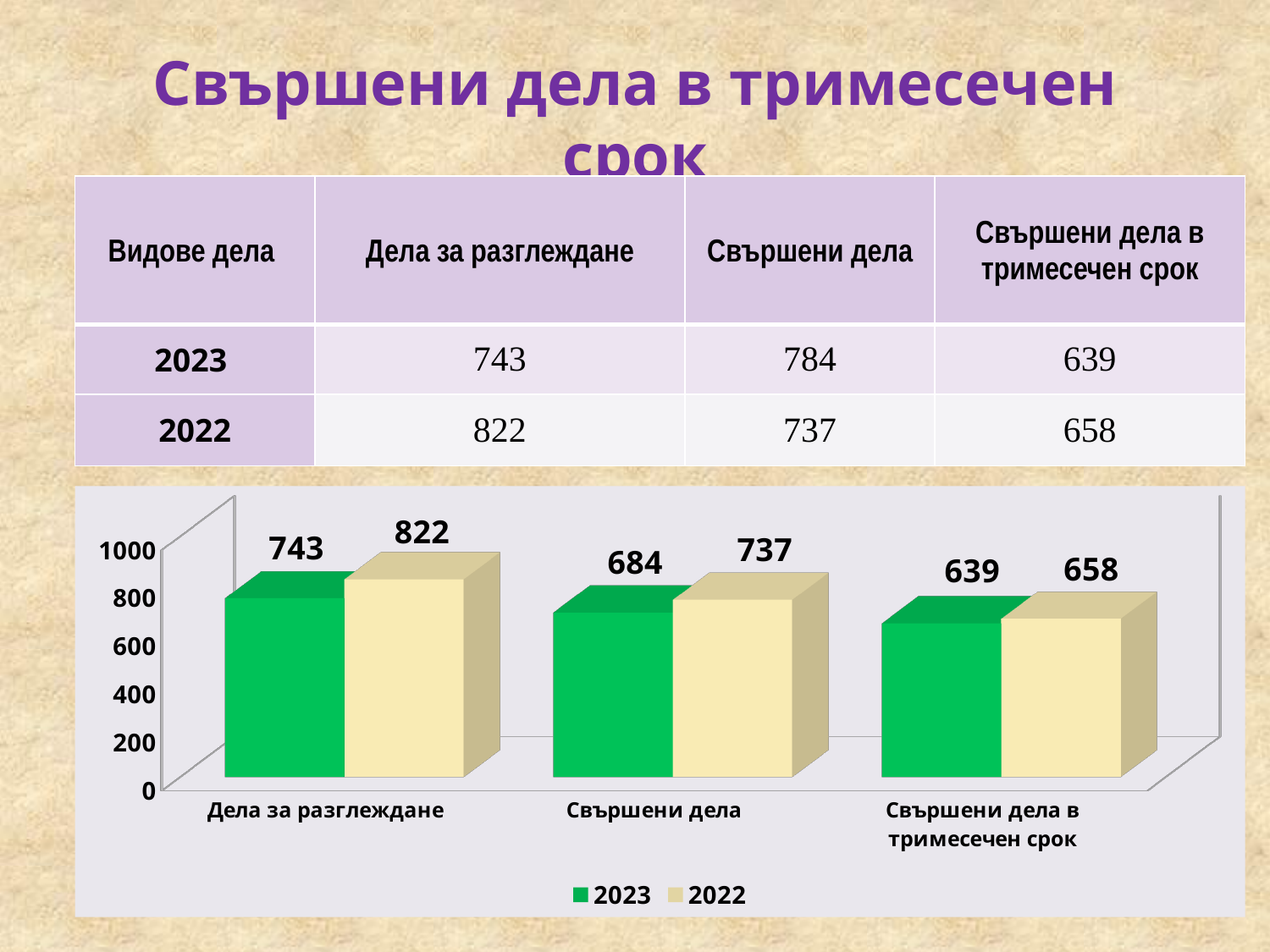
How many categories are shown on the x axis of the chart? 3 Which category has the lowest value for the 2023 series? Свършени дела в тримесечен срок What is the value for 2022 in the "Дела за разглеждане" category? 822 Which colour represents the 2023 series in the chart? Green What is the difference between the 2022 and 2023 values in the "Дела за разглеждане" category? 79 Which category has the highest value for the 2022 series? Дела за разглеждане What is the value for 2023 in the "Свършени дела в тримесечен срок" category? 639 How many series does the chart legend list? 2 In the "Свършени дела" category, which series has the larger value, 2023 or 2022? 2022 What is the value for 2023 in the "Дела за разглеждане" category? 743 What kind of chart is shown on the slide? Bar chart What is the value for 2022 in the "Свършени дела" category? 737